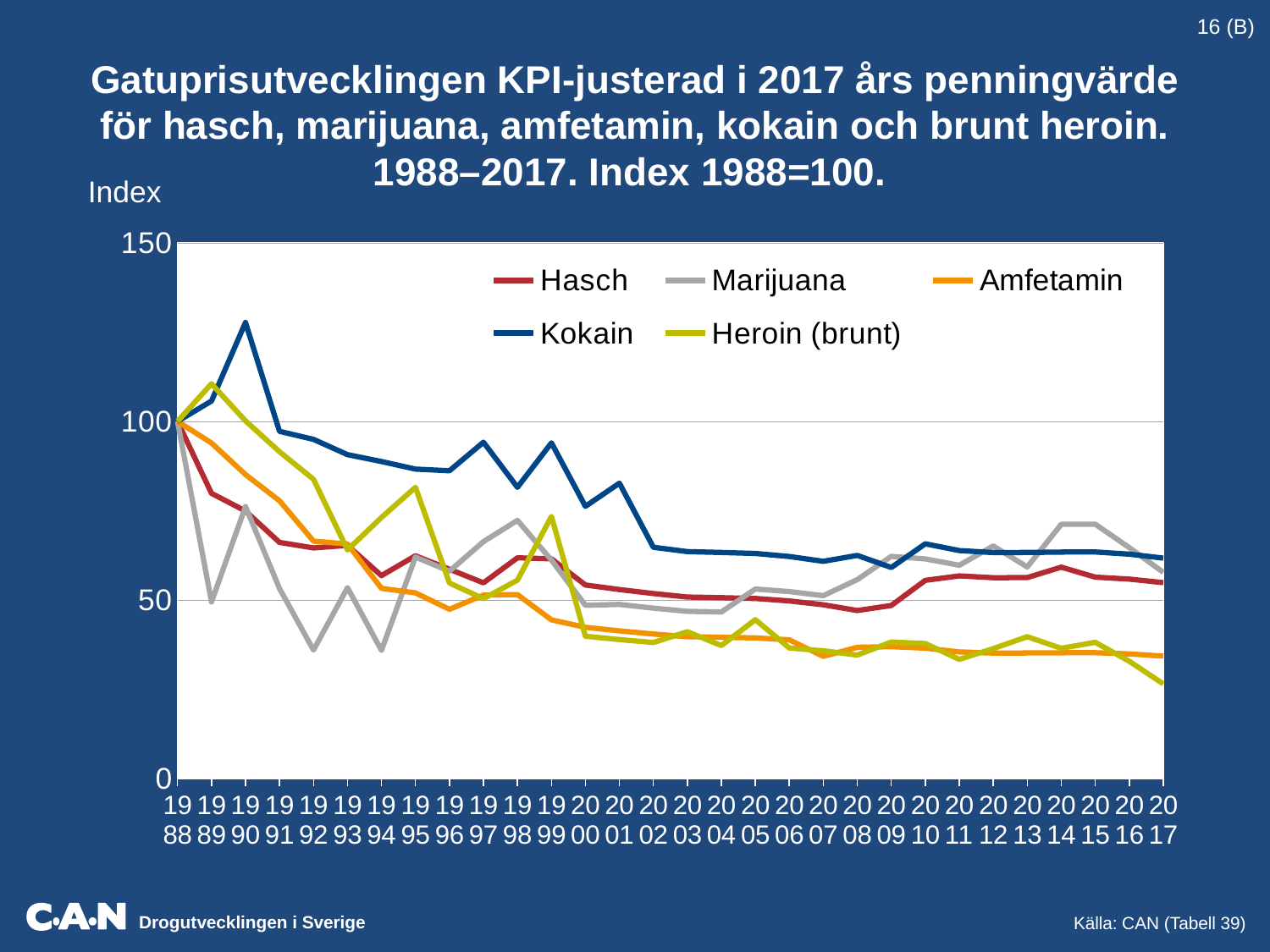
Which series has the highest value in 1990? Kokain In 2017, which is larger: the value for Kokain or the value for Hasch? Kokain Is the value for Kokain in 1990 greater or less than 100? greater Is the value for Heroin (brunt) in 2017 greater or less than 50? less Which series has the lowest value in 2017? Heroin (brunt) Is the value for Marijuana in 1992 greater or less than 50? less How many series does the legend list? 5 How many years are plotted along the x axis? 30 What colour is the Kokain line in the legend? blue What kind of chart is shown on the slide? line chart What is the index value for Hasch in 1988? 100 Does the Hasch series rise or fall from 1988 to 2017? fall